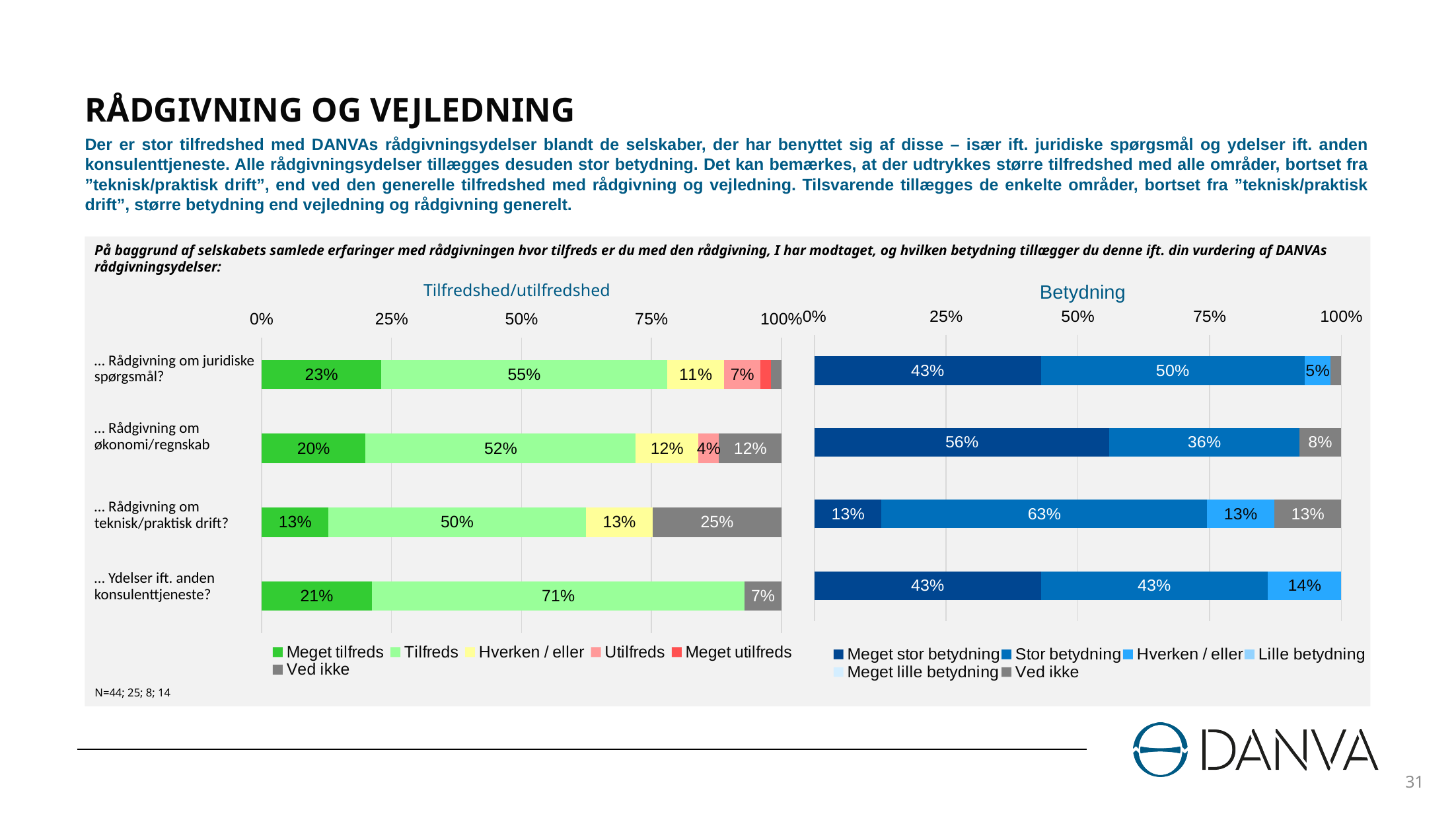
In the "Betydning" chart, what is the "Stor betydning" value for "Rådgivning om teknisk/praktisk drift?"? 63% In the "Betydning" chart, what is the "Meget stor betydning" value for "Rådgivning om økonomi/regnskab"? 56% In the "Tilfredshed/utilfredshed" chart, what is the combined share of "Meget tilfreds" and "Tilfreds" for "Rådgivning om økonomi/regnskab"? 72% In the "Betydning" chart, which category has the lowest "Meget stor betydning" value? Rådgivning om teknisk/praktisk drift? In the "Tilfredshed/utilfredshed" chart, what is the "Tilfreds" value for "Ydelser ift. anden konsulenttjeneste?"? 71% In the "Tilfredshed/utilfredshed" chart, what is the "Ved ikke" value for "Rådgivning om teknisk/praktisk drift?"? 25% In the "Betydning" chart, which is larger for "Rådgivning om juridiske spørgsmål?": "Meget stor betydning" or "Stor betydning"? Stor betydning How many series does the legend of the "Tilfredshed/utilfredshed" chart list? 6 What kind of chart is the "Betydning" chart? Stacked bar chart In the "Tilfredshed/utilfredshed" chart, what is the difference between the "Tilfreds" values for "Ydelser ift. anden konsulenttjeneste?" and "Rådgivning om teknisk/praktisk drift?"? 21% How many categories are shown in the "Betydning" chart? 4 In the "Tilfredshed/utilfredshed" chart, which category has the highest "Meget tilfreds" value? Rådgivning om juridiske spørgsmål?